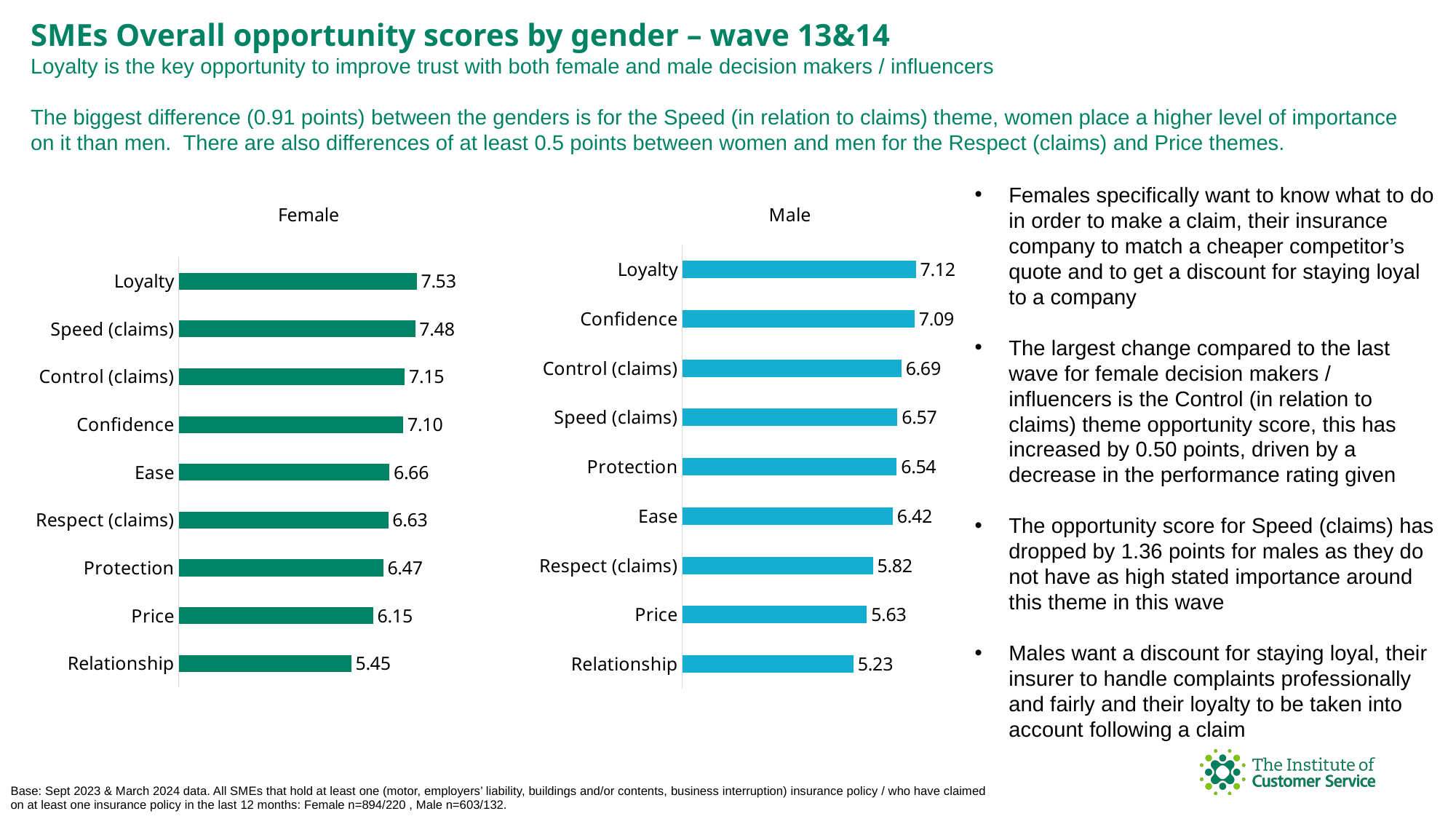
In the Male chart, which theme has the highest opportunity score? Loyalty In the Male chart, what is the opportunity score for Respect (claims)? 5.82 Which chart has the higher score for Confidence, Female or Male? Female How many themes are shown in the Male chart? 9 In the Female chart, which is larger: the score for Price or the score for Protection? Protection What type of chart is the Female chart? Bar chart What colour are the bars in the Male chart? Light blue In the Female chart, what is the opportunity score for Loyalty? 7.53 What is the difference between the Female and Male scores for Speed (claims)? 0.91 In the Male chart, what is the difference between the Loyalty score and the Relationship score? 1.89 In the Female chart, what is the opportunity score for Ease? 6.66 In the Female chart, which theme has the lowest opportunity score? Relationship